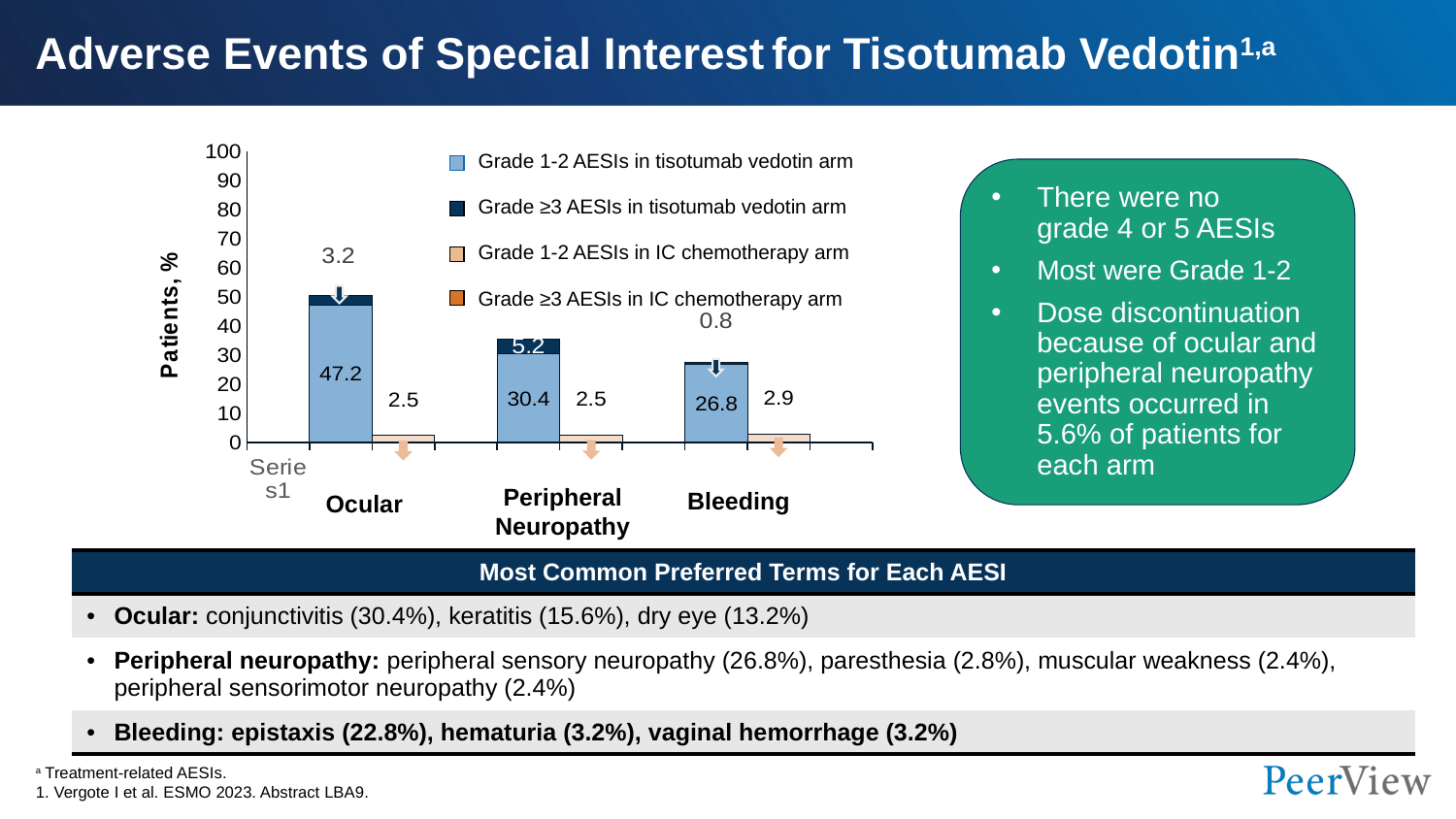
What kind of chart is shown on the slide? Stacked bar chart How many series does the chart legend list? 4 What is the percentage of patients with Grade 1-2 bleeding AESIs in the IC chemotherapy arm? 2.9 How many AESI categories are shown on the x axis of the chart? 3 Is the Grade 1-2 ocular AESI percentage in the tisotumab vedotin arm greater or less than the Grade 1-2 bleeding AESI percentage in the same arm? greater What is the percentage of patients with Grade ≥3 peripheral neuropathy AESIs in the tisotumab vedotin arm? 5.2 What is the difference between the Grade 1-2 ocular and Grade 1-2 peripheral neuropathy percentages in the tisotumab vedotin arm? 16.8 Which AESI category has the lowest percentage of Grade ≥3 events in the tisotumab vedotin arm? Bleeding Which AESI category has the highest percentage of Grade 1-2 events in the tisotumab vedotin arm? Ocular What is the percentage of patients with Grade ≥3 bleeding AESIs in the tisotumab vedotin arm? 0.8 What is the percentage of patients with Grade 1-2 ocular AESIs in the tisotumab vedotin arm? 47.2 What is the total stacked percentage (Grade 1-2 plus Grade ≥3) for ocular AESIs in the tisotumab vedotin arm? 50.4